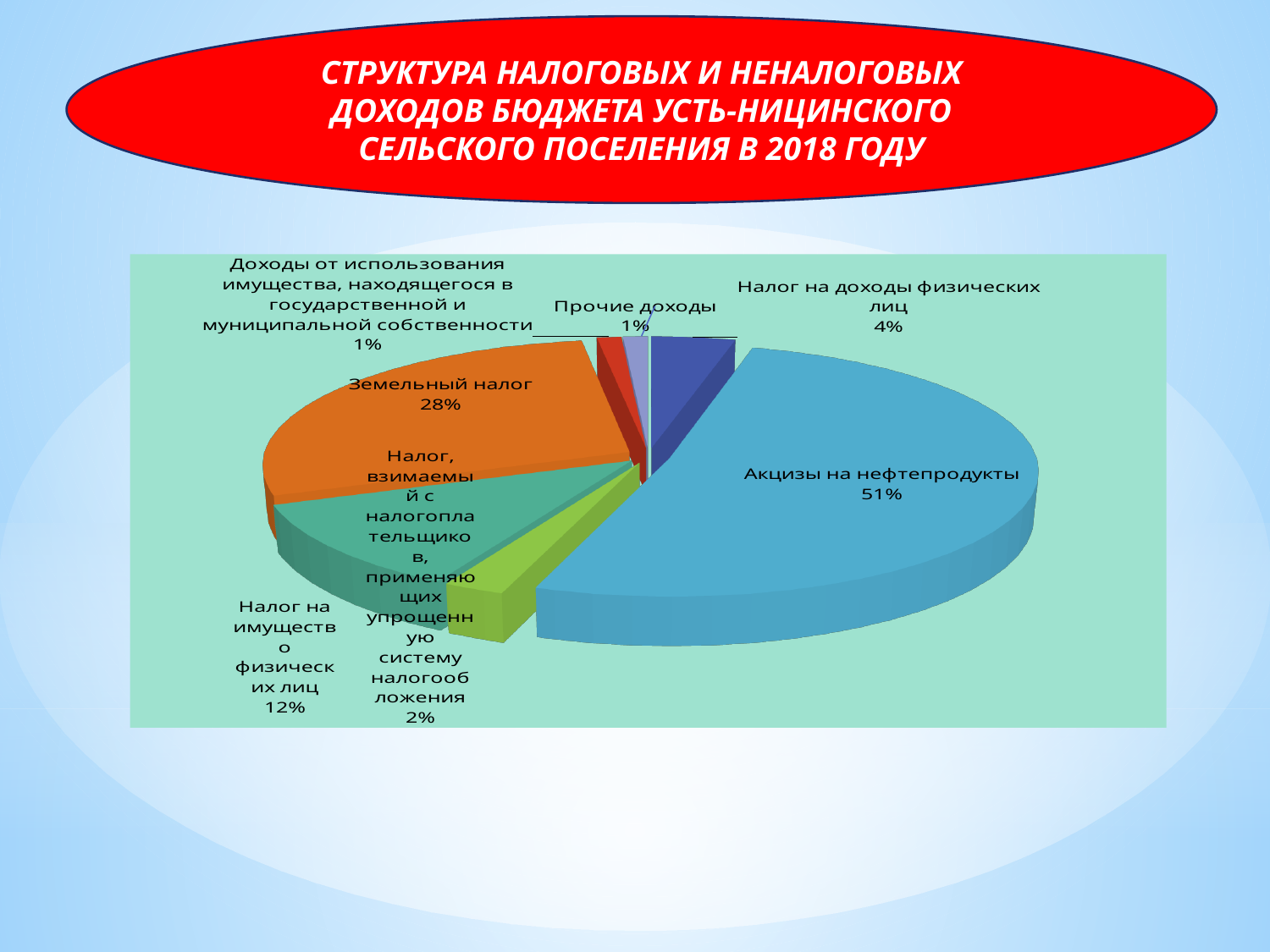
Какую долю составляет налог, взимаемый с налогоплательщиков, применяющих упрощенную систему налогообложения? 2% На сколько процентных пунктов доля акцизов на нефтепродукты больше доли земельного налога? 23 Какой источник доходов имеет наибольшую долю? Акцизы на нефтепродукты Какую долю составляют прочие доходы? 1% Какую долю составляет налог на доходы физических лиц? 4% Какую долю составляет земельный налог? 28% Какой тип диаграммы показан на слайде? Круговая диаграмма Какую долю составляет налог на имущество физических лиц? 12% Каким цветом показан сектор «Земельный налог»? Оранжевым Какую долю составляют акцизы на нефтепродукты? 51% Сколько секторов (категорий) показано на диаграмме? 7 Что больше: доля земельного налога или доля налога на имущество физических лиц? Земельный налог